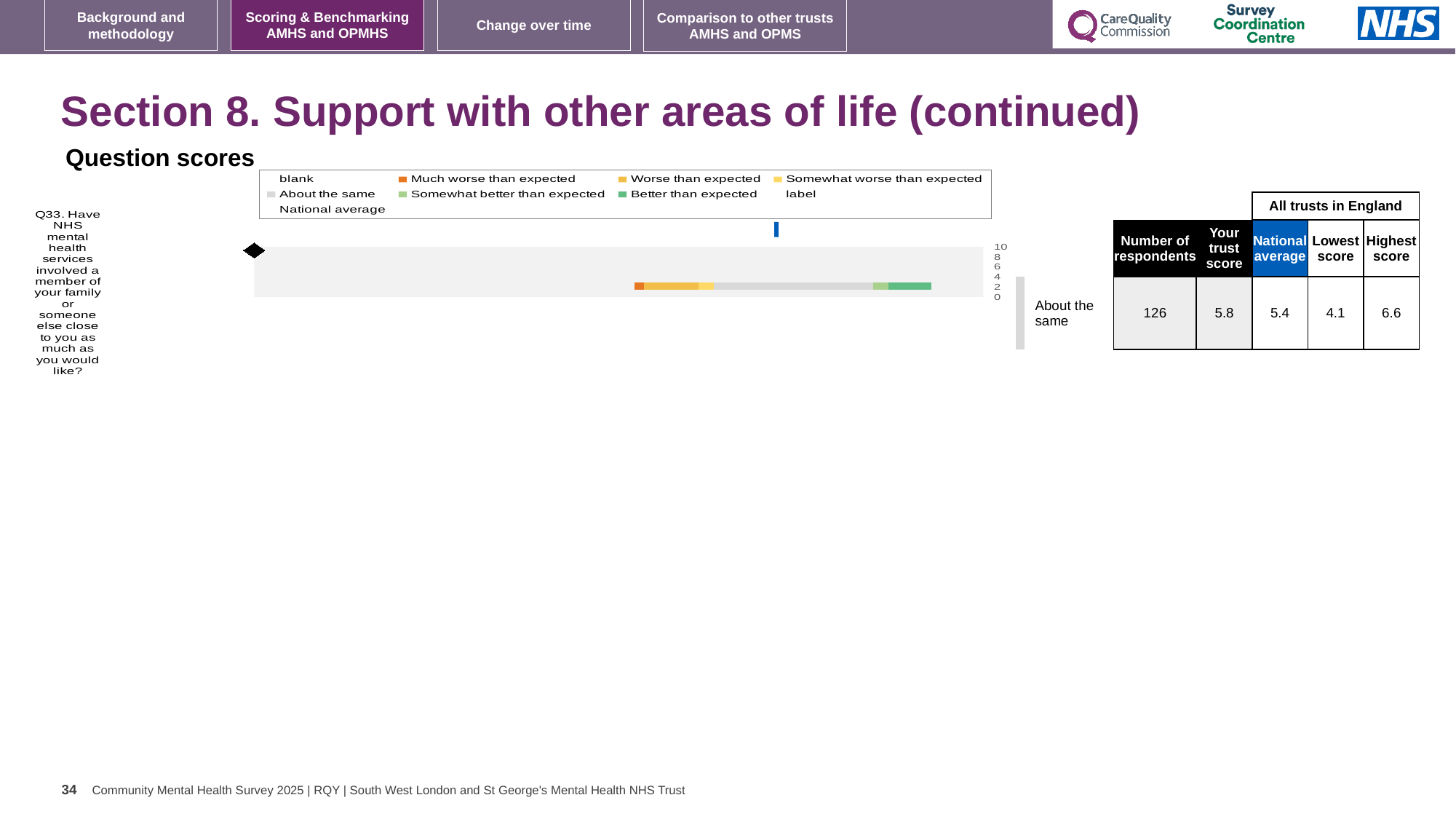
Is the trust's score for Q33 higher or lower than the national average? higher What is the heading above the chart? Question scores What is the highest value shown on the chart's axis? 10 What is the national average score for Q33? 5.4 What benchmark category is shown for Q33 next to the chart? About the same What is the highest score among all trusts in England for Q33? 6.6 How many questions (categories) are plotted in the chart? 1 What kind of chart is shown on the slide? bar chart How many entries does the chart legend list? 9 What is the number of respondents for Q33? 126 Which legend entry is shown in orange? Much worse than expected What is the trust's score for Q33? 5.8